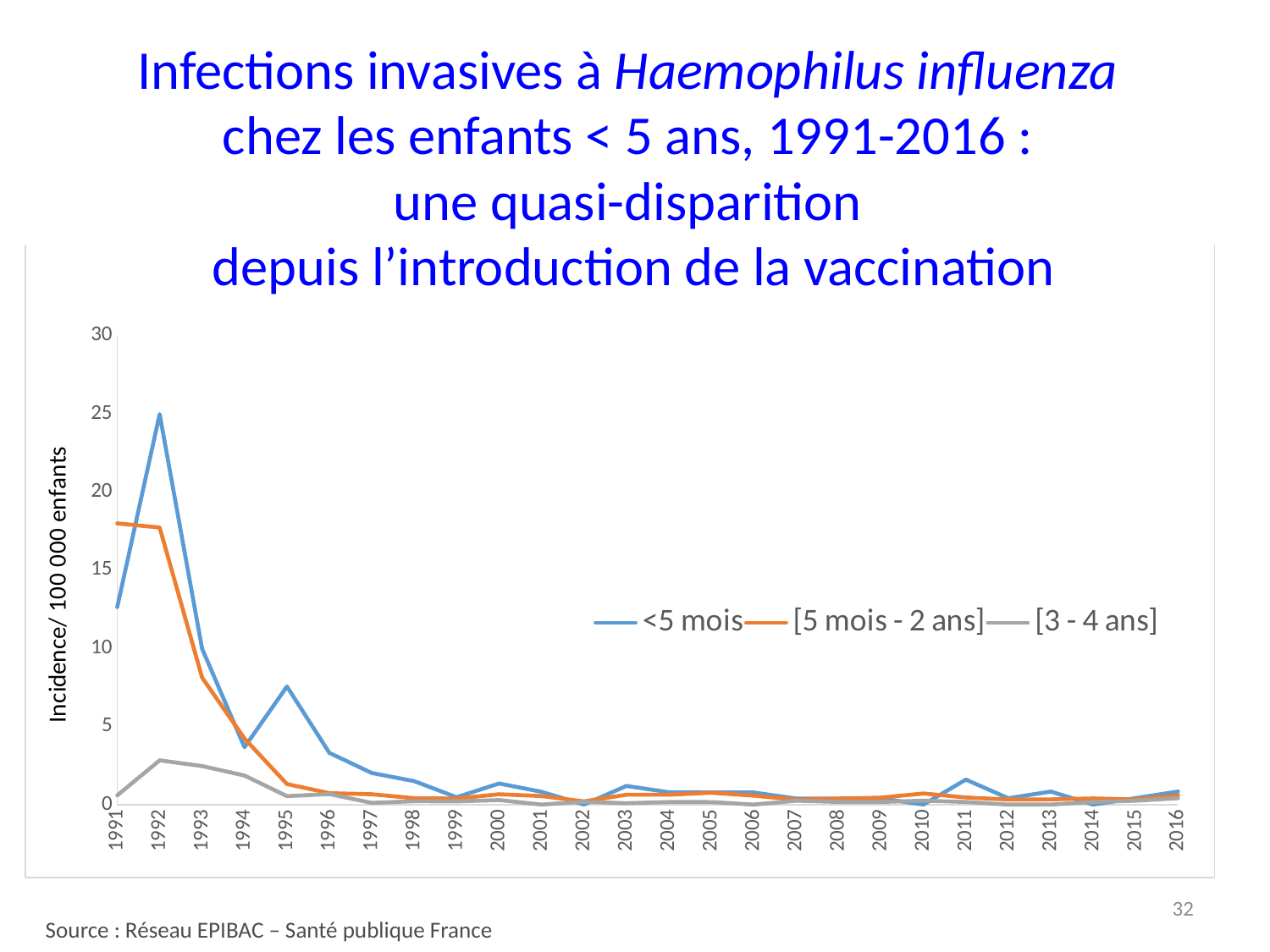
What kind of chart is shown on the slide? line chart What is the label of the y axis? Incidence/ 100 000 enfants How many years are plotted along the x axis? 26 In which year does the "<5 mois" series reach its highest value? 1992 Which series reaches the highest peak on the chart? <5 mois Is the value for "[5 mois - 2 ans]" in 1991 greater or less than 15? greater Is the value for "<5 mois" in 1992 greater or less than 20? greater How many series does the legend list? 3 In 1991, which is larger: "<5 mois" or "[5 mois - 2 ans]"? [5 mois - 2 ans] Is the value for "[3 - 4 ans]" in 1992 greater or less than 5? less Does the "<5 mois" series rise or fall between 1992 and 1994? fall